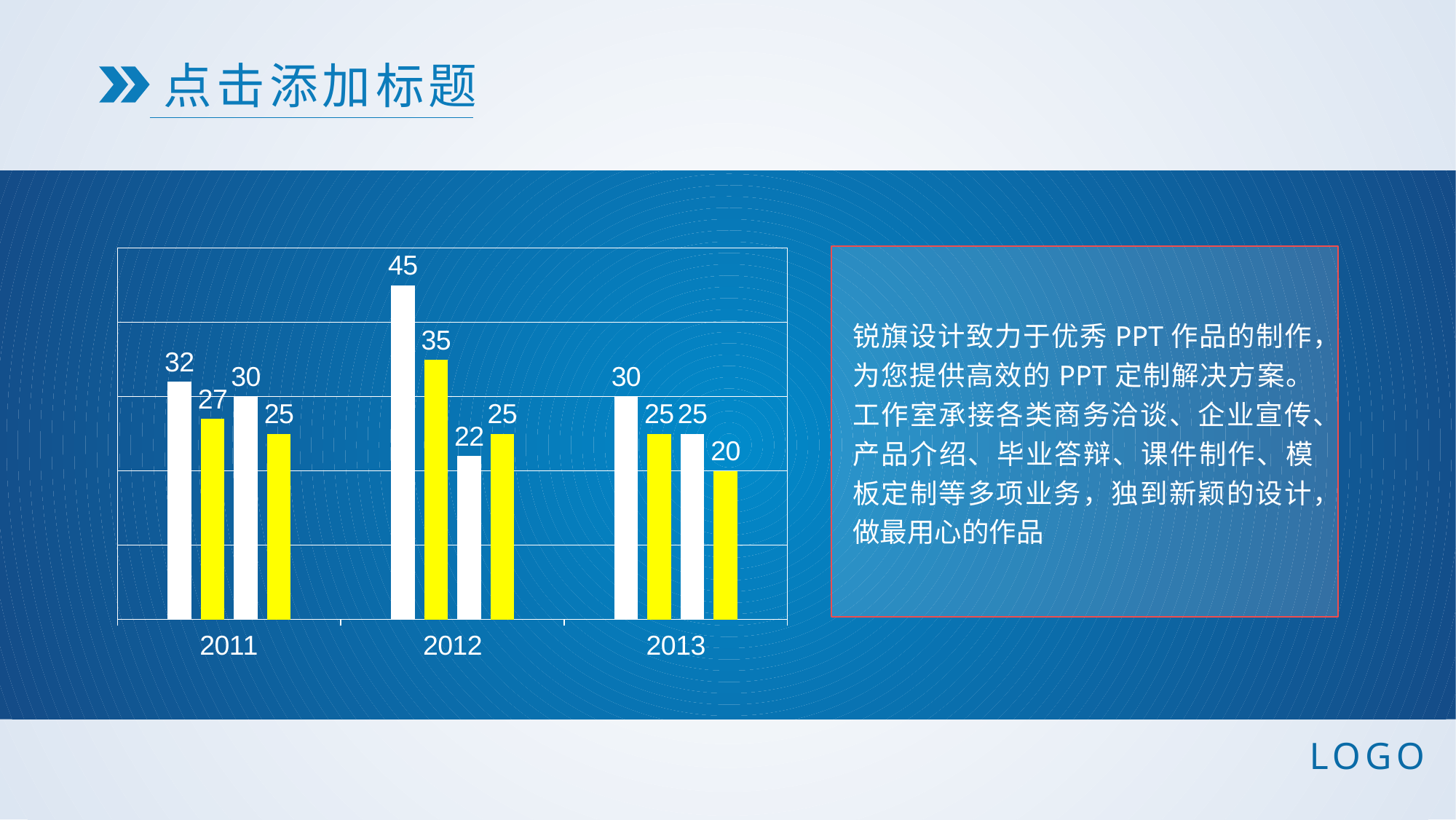
What is the difference between the first bar in 2012 (45) and the first bar in 2011 (32)? 13 How many categories are shown on the x axis of the chart? 3 How many bars are there in each year group? 4 What is the value of the first (leftmost) bar in the 2011 group? 32 What type of chart is shown on the slide? bar chart Which is larger: the second bar in 2012 or the second bar in 2013? the second bar in 2012 What is the lowest value labelled in the chart? 20 What two colours are used for the bars in the chart? white and yellow What is the value of the third bar in the 2012 group? 22 What is the value of the tallest bar in the 2012 group? 45 What is the value of the last (rightmost) bar in the 2013 group? 20 Which year group contains the highest bar in the chart? 2012